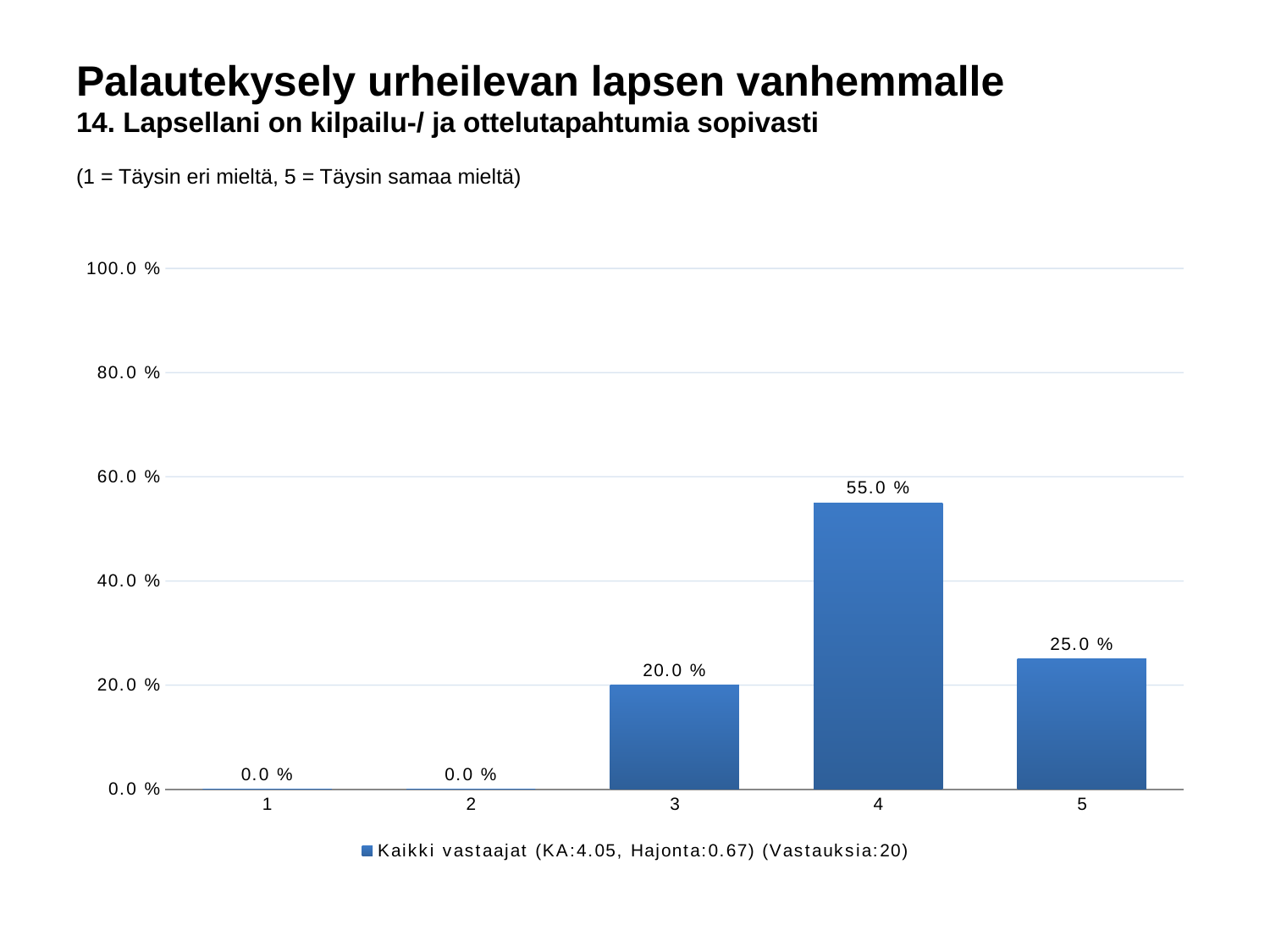
Is the value for category 4 greater or less than 40.0 %? greater How many responses (Vastauksia) does the legend report? 20 What is the value for category 1? 0.0 % What is the value for category 5? 25.0 % How many categories are shown on the x axis? 5 Which category has the highest value? 4 Which is larger, the value for category 3 or category 5? 5 What is the difference between the values for category 4 and category 5? 30.0 % What is the value for category 4? 55.0 % What kind of chart is shown? bar chart What is the value for category 3? 20.0 % How many series does the legend list? 1